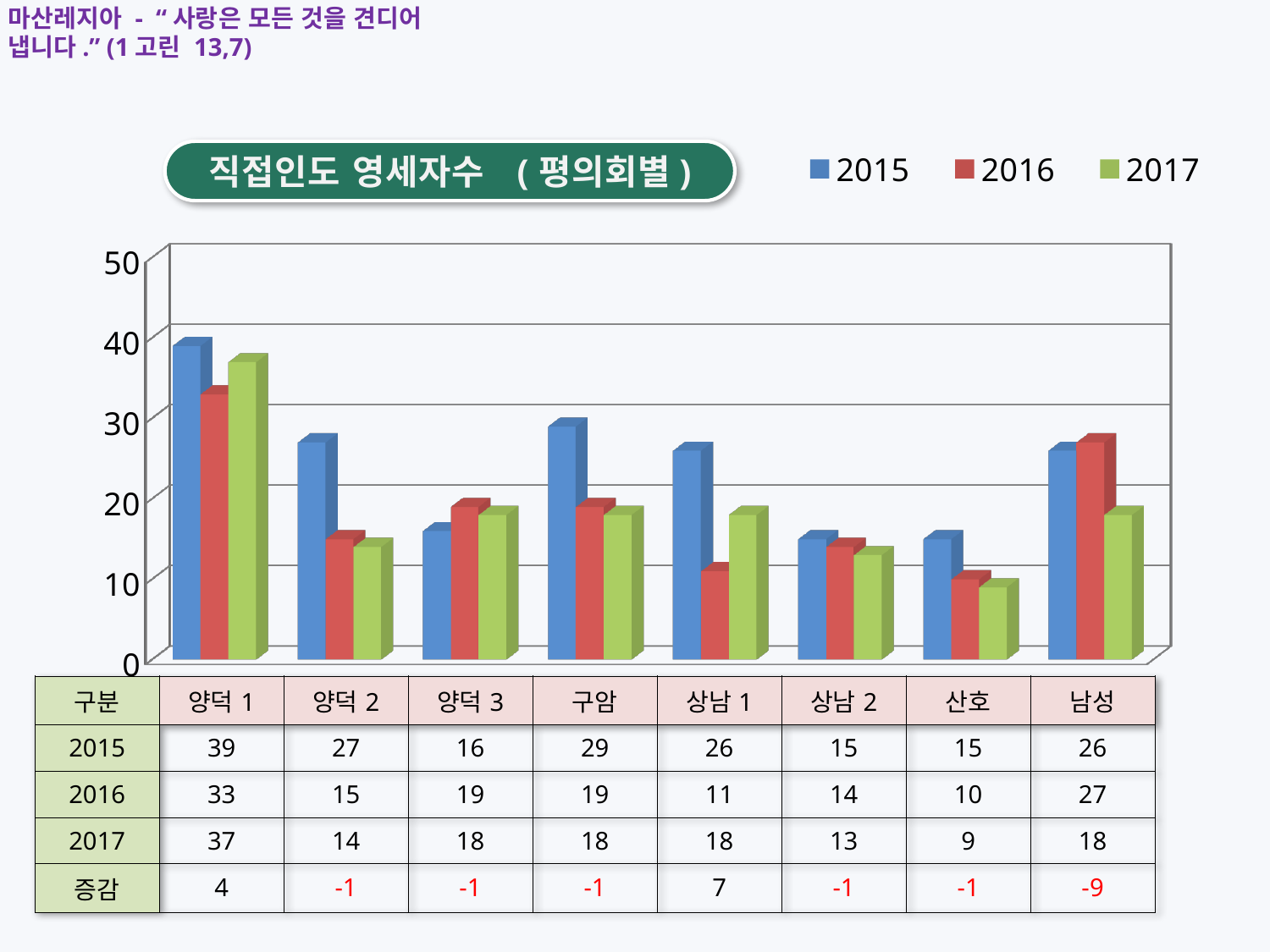
How many series does the legend list? 3 What is the 2015 value for 양덕 1? 39 What type of chart is shown on the slide? bar chart What is the title of the chart? 직접인도 영세자수 (평의회별) How many categories (평의회) are shown on the x axis? 8 What is the 2017 value for 산호? 9 What is the difference between the 2015 and 2017 values for 남성? 8 Which category has the highest 2015 value? 양덕 1 Which is larger for 양덕 3: the 2015 value or the 2016 value? 2016 Is the 2015 value for 구암 greater or less than 20? greater Which category has the lowest 2017 value? 산호 What is the 2016 value for 상남 1? 11